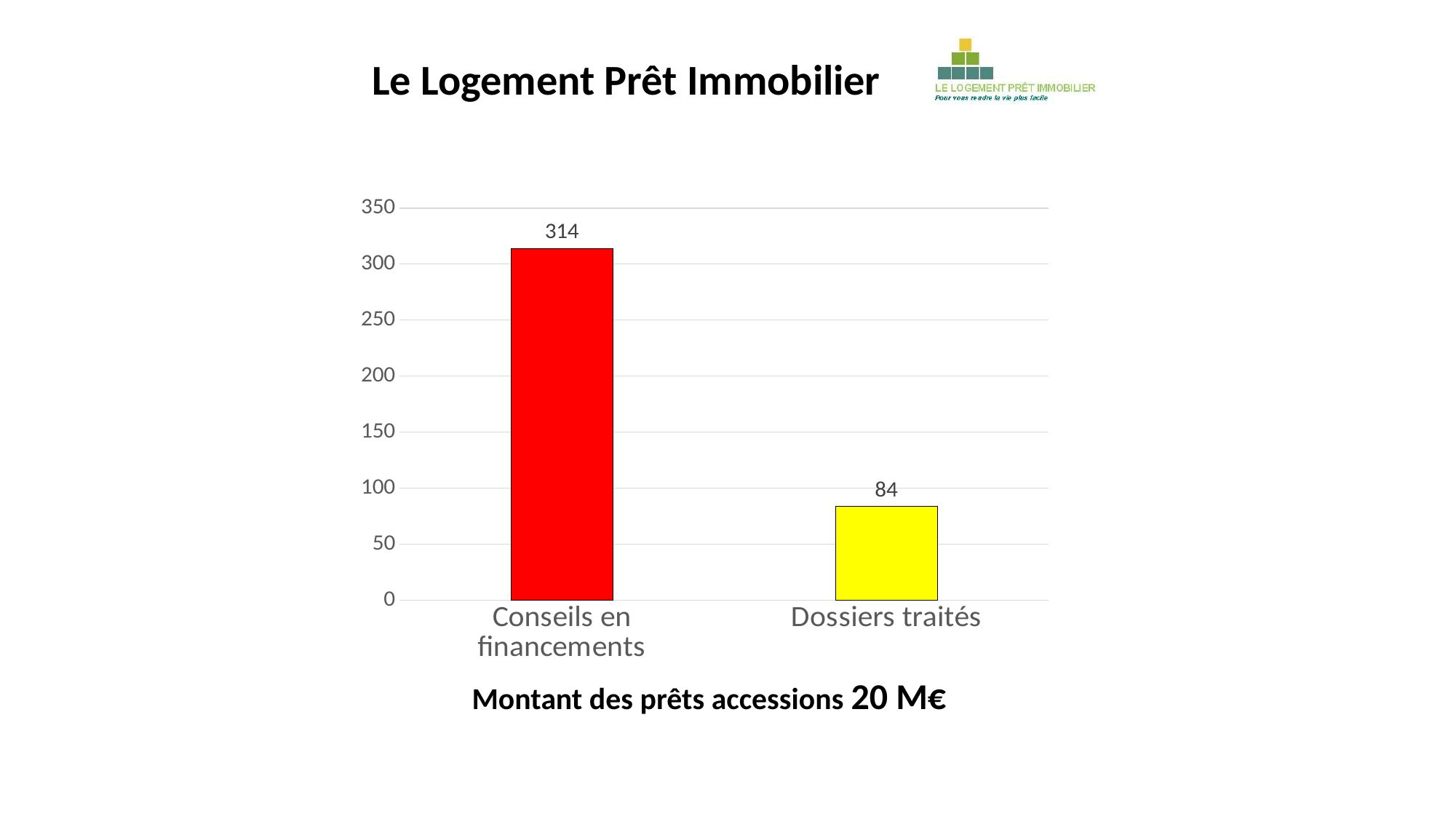
What is the value for Conseils en financements? 314 What is the highest value shown on the vertical axis? 350 Which is larger, the value for Conseils en financements or the value for Dossiers traités? Conseils en financements What colour is the bar for Dossiers traités? yellow Is the value for Dossiers traités greater or less than 100? less Is the value for Conseils en financements greater or less than 300? greater What is the difference between the values for Conseils en financements and Dossiers traités? 230 What is the value for Dossiers traités? 84 Which category has the lowest value? Dossiers traités How many categories are shown on the chart? 2 What kind of chart is shown on the slide? bar chart Which category has the highest value? Conseils en financements